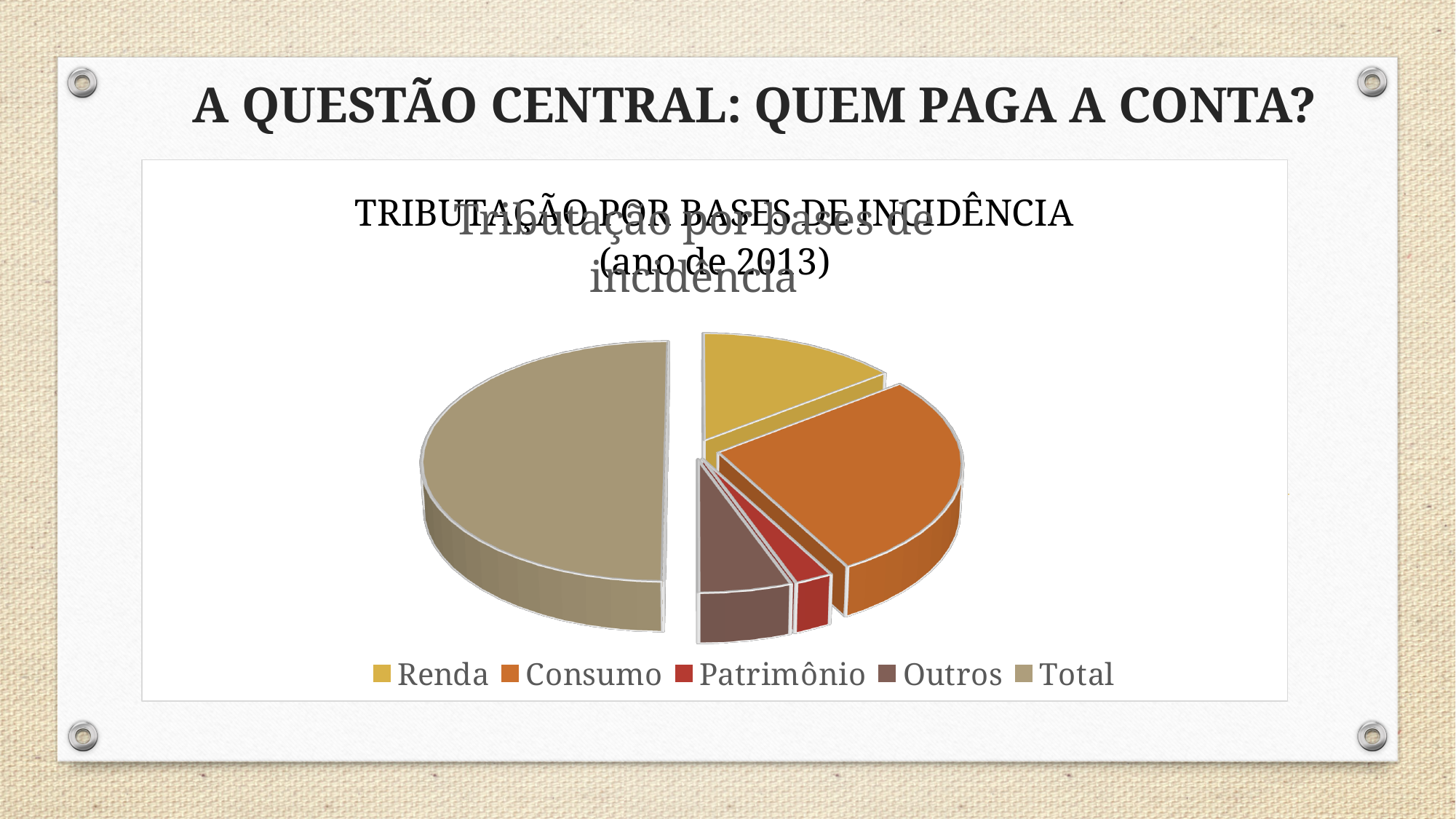
Which slice is larger, Consumo or Renda? Consumo Which slice is larger, Total or Consumo? Total Which slice is larger, Outros or Patrimônio? Outros Which category has the smallest slice in the pie chart? Patrimônio Which year does the chart title say the data refers to? 2013 Which category has the largest slice in the pie chart? Total What colour is the Consumo slice in the pie chart? orange How many slices does the pie chart have? 5 What kind of chart is shown on the slide? pie chart